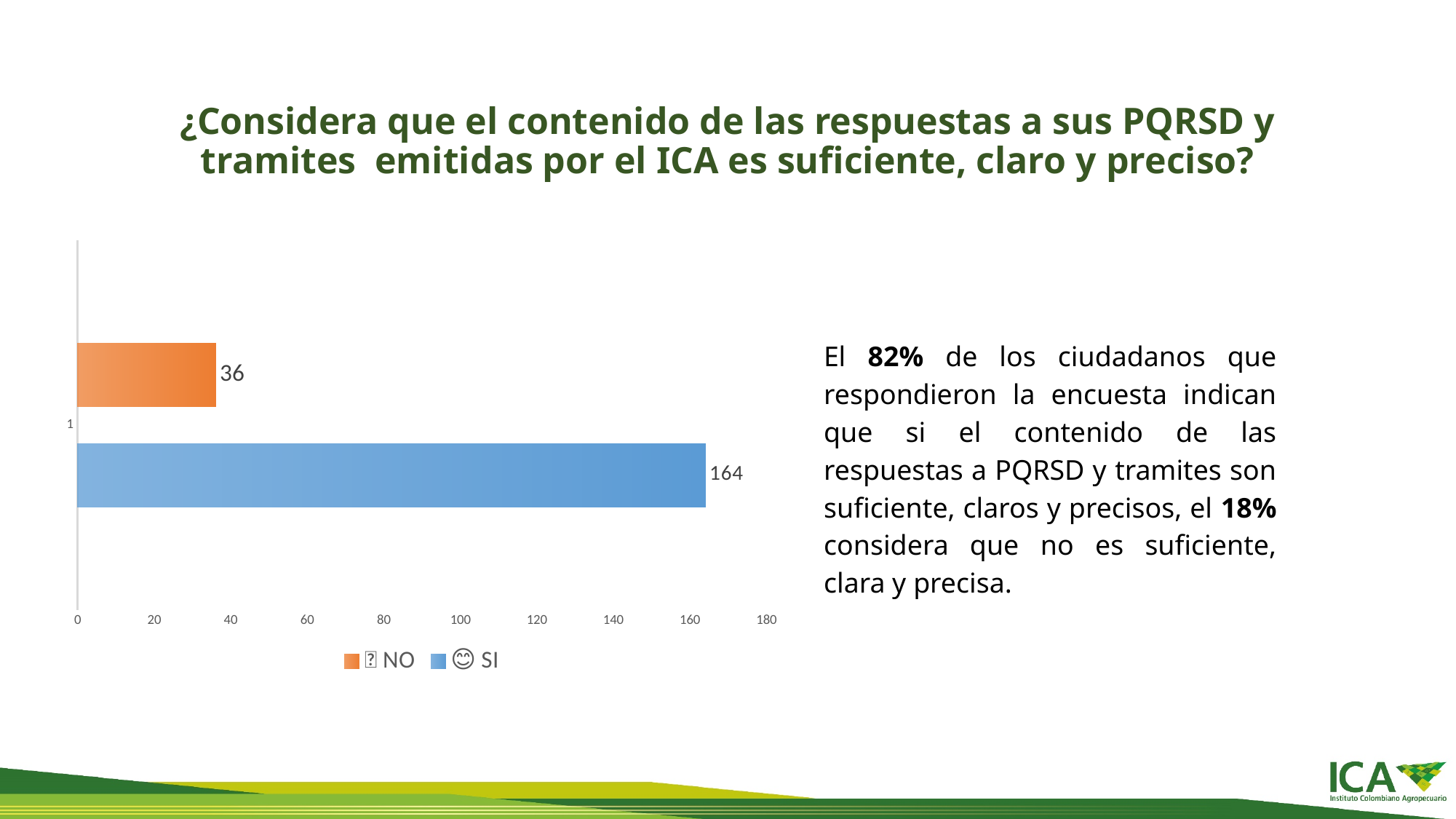
Is the value for NO greater or less than 60? less What is the value for NO? 36 What is the value for SI? 164 Is the value for SI greater or less than 140? greater What is the difference between the SI value and the NO value? 128 Which series has the higher value, SI or NO? SI What is the total of the SI and NO values combined? 200 What kind of chart is shown on the slide? bar chart Which series has the lower value, SI or NO? NO What colour is the bar for SI? blue Is the value for NO larger or smaller than the value for SI? smaller How many series does the legend list? 2